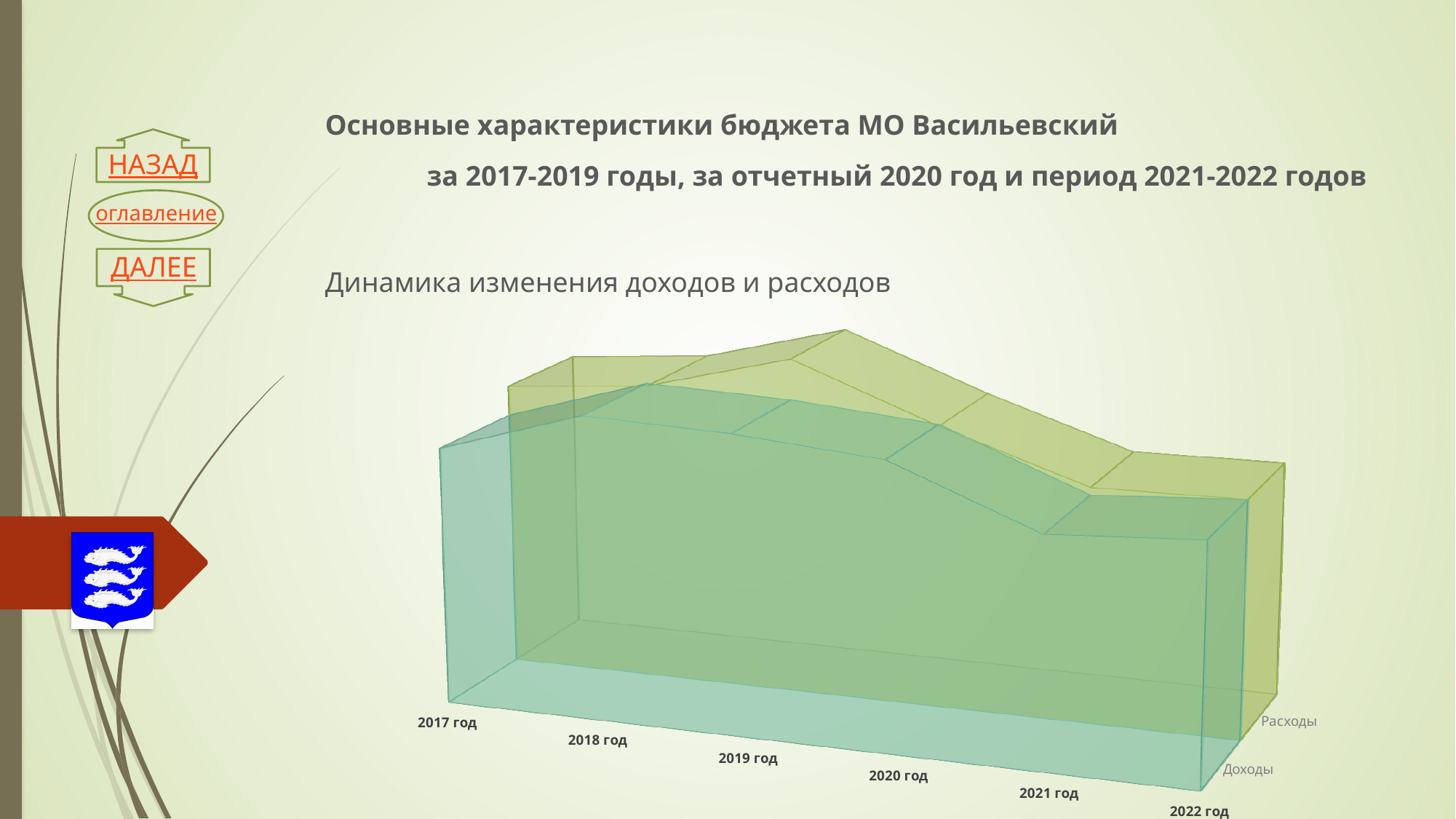
What are the names of the two series in the chart? Расходы and Доходы What is the last year shown on the x axis of the chart? 2022 год What is the first year shown on the x axis of the chart? 2017 год How many series does the chart show? 2 What kind of chart is shown on the slide? area chart What is the title of the chart? Динамика изменения доходов и расходов Does the Доходы series rise or fall from 2017 год to 2018 год? rise How many years (categories) are shown along the x axis of the chart? 6 Which is larger for the Доходы series: the value for 2018 год or the value for 2021 год? 2018 год